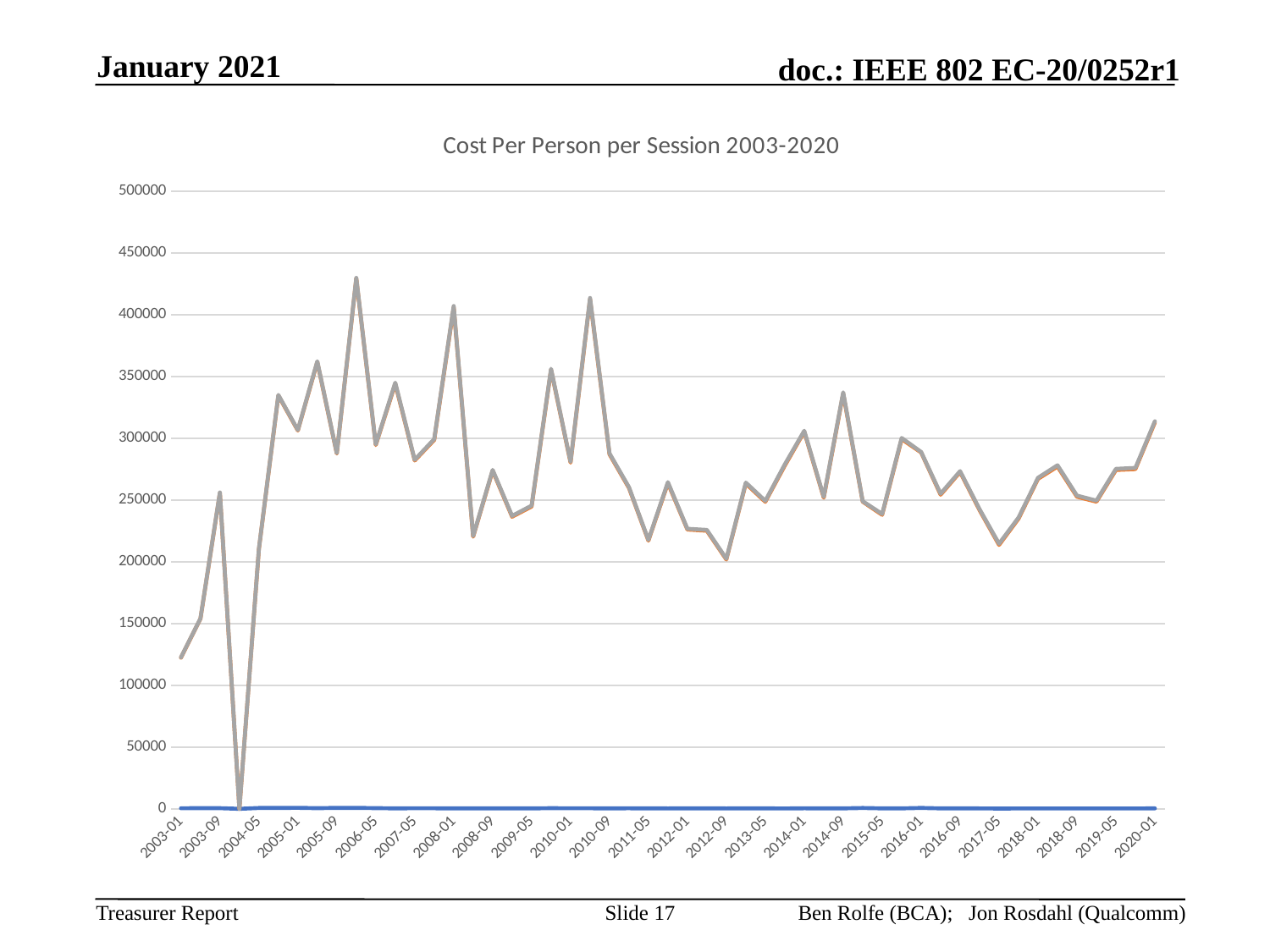
Is the value for 2005-09 greater or less than 300000? less Which is larger, the value for 2003-01 or the value for 2020-01? 2020-01 Is the value for 2020-01 greater or less than 300000? greater Which is larger, the value for 2014-09 or the value for 2017-05? 2014-09 Is the value for 2017-05 greater or less than 250000? less What is the highest value shown on the vertical axis? 500000 What is the title of the chart? Cost Per Person per Session 2003-2020 How many labels are shown along the x axis? 26 What kind of chart is shown on the slide? line chart